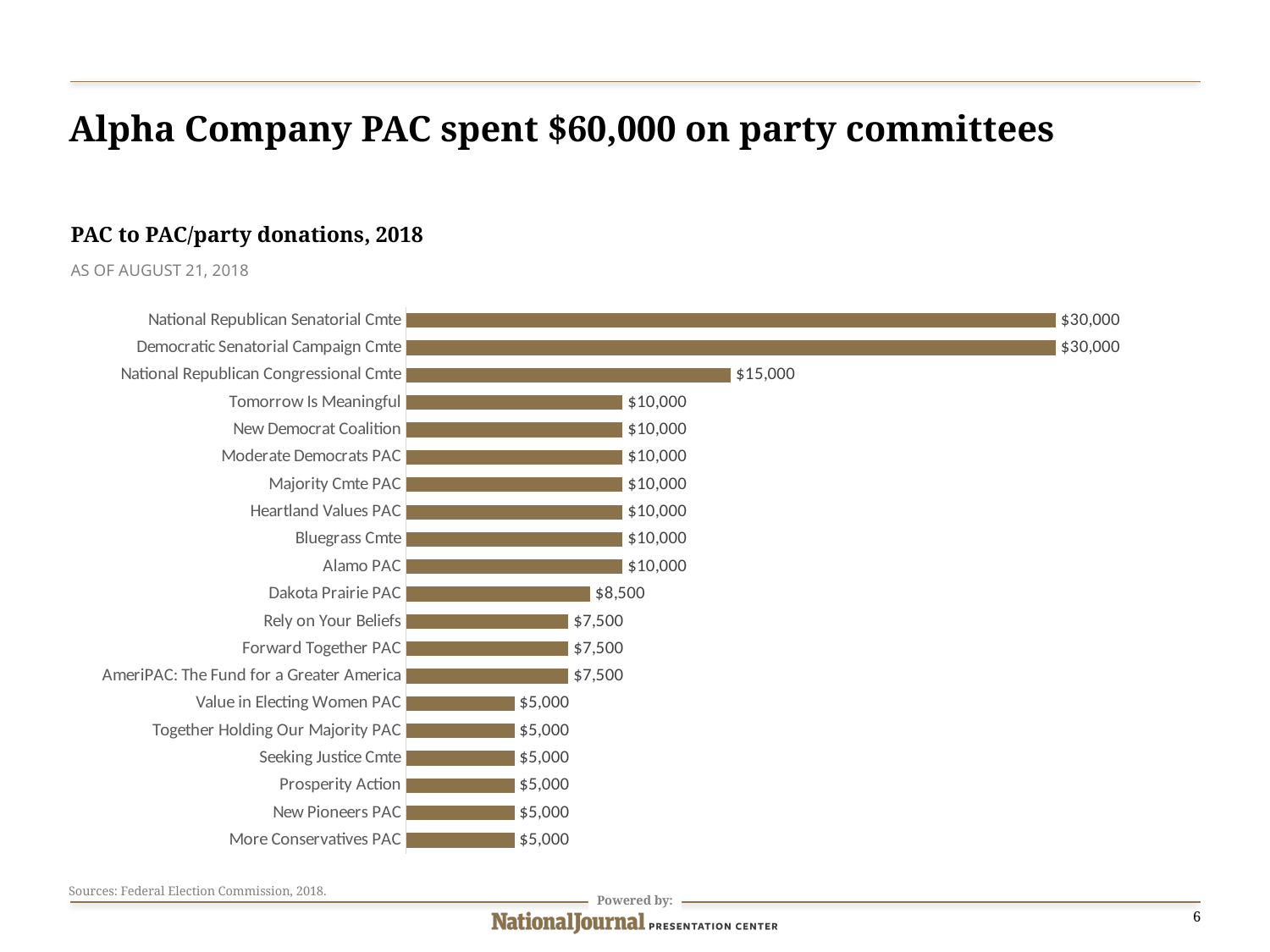
What kind of chart is shown on the slide? bar chart What is the difference between the donation to Alamo PAC and the donation to More Conservatives PAC? $5,000 What is the value shown for Forward Together PAC? $7,500 What is the value shown for Dakota Prairie PAC? $8,500 How many recipients are listed on the chart? 20 What is the difference between the donation to the National Republican Senatorial Cmte and the donation to the National Republican Congressional Cmte? $15,000 What is the largest donation amount shown on the chart? $30,000 How much did Alpha Company PAC donate to the National Republican Congressional Cmte? $15,000 What is the smallest donation amount shown on the chart? $5,000 What is the title of the chart? PAC to PAC/party donations, 2018 What is the value shown for Democratic Senatorial Campaign Cmte? $30,000 Which received more: Dakota Prairie PAC or Rely on Your Beliefs? Dakota Prairie PAC